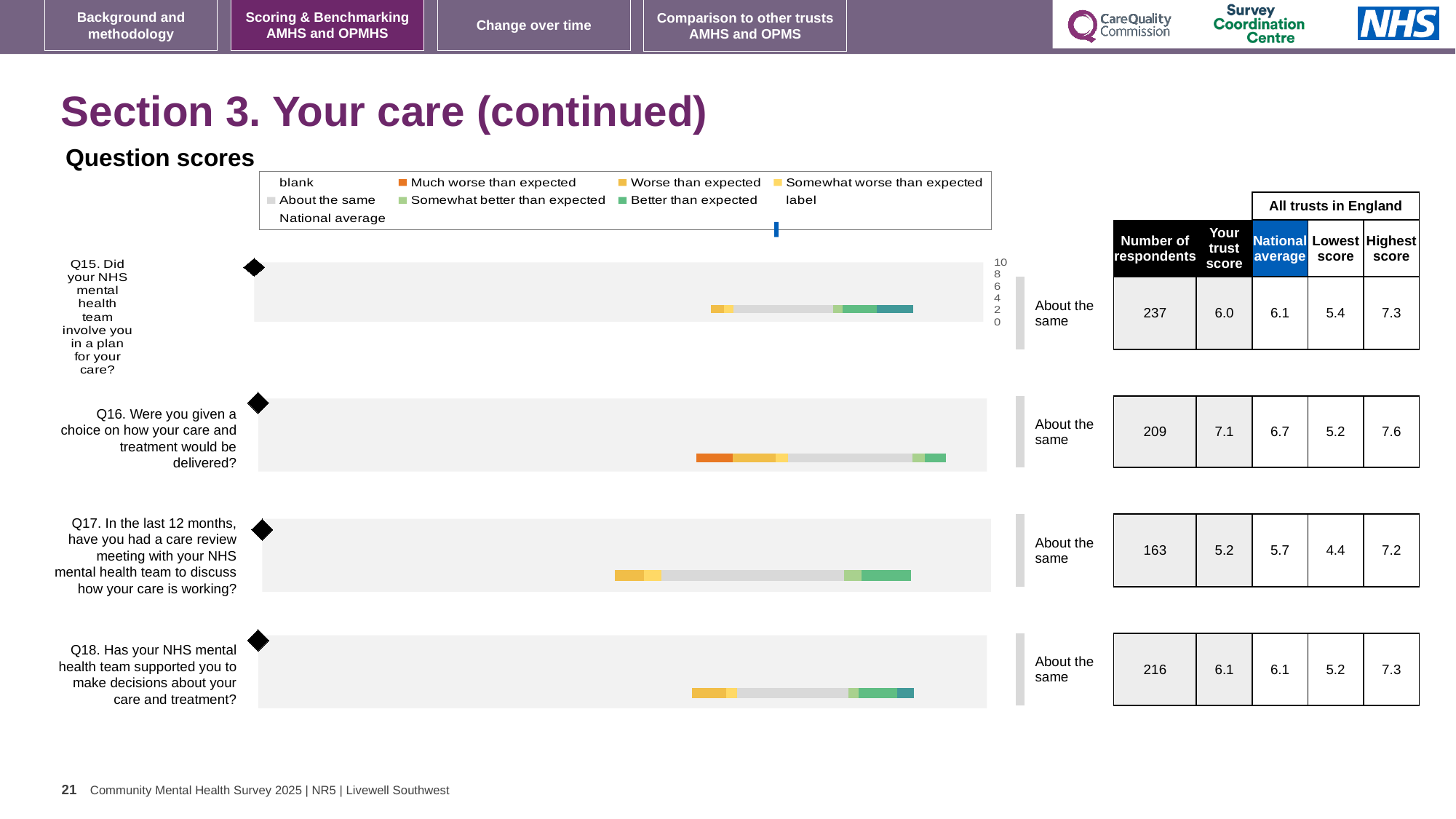
For Q16, how much higher is the trust score (7.1) than the national average (6.7)? 0.4 What is the highest score among all trusts in England for Q18? 7.3 Which question has the highest 'Your trust score' on the slide? Q16 Which question has the lowest 'Your trust score' on the slide? Q17 How many questions (Q15 to Q18) have a score bar on the slide? 4 For Q17, what is the difference between the highest score (7.2) and the lowest score (4.4) among all trusts in England? 2.8 What benchmark category label is shown next to each of the four question bars? About the same What kind of chart is used to show the question scores for Q15 to Q18? bar chart What is the 'Your trust score' value for Q16 (Were you given a choice on how your care and treatment would be delivered)? 7.1 For Q15, which is larger: the trust score or the national average? National average What is the lowest score among all trusts in England for Q15? 5.4 How many respondents are listed for Q17 (care review meeting in the last 12 months)? 163